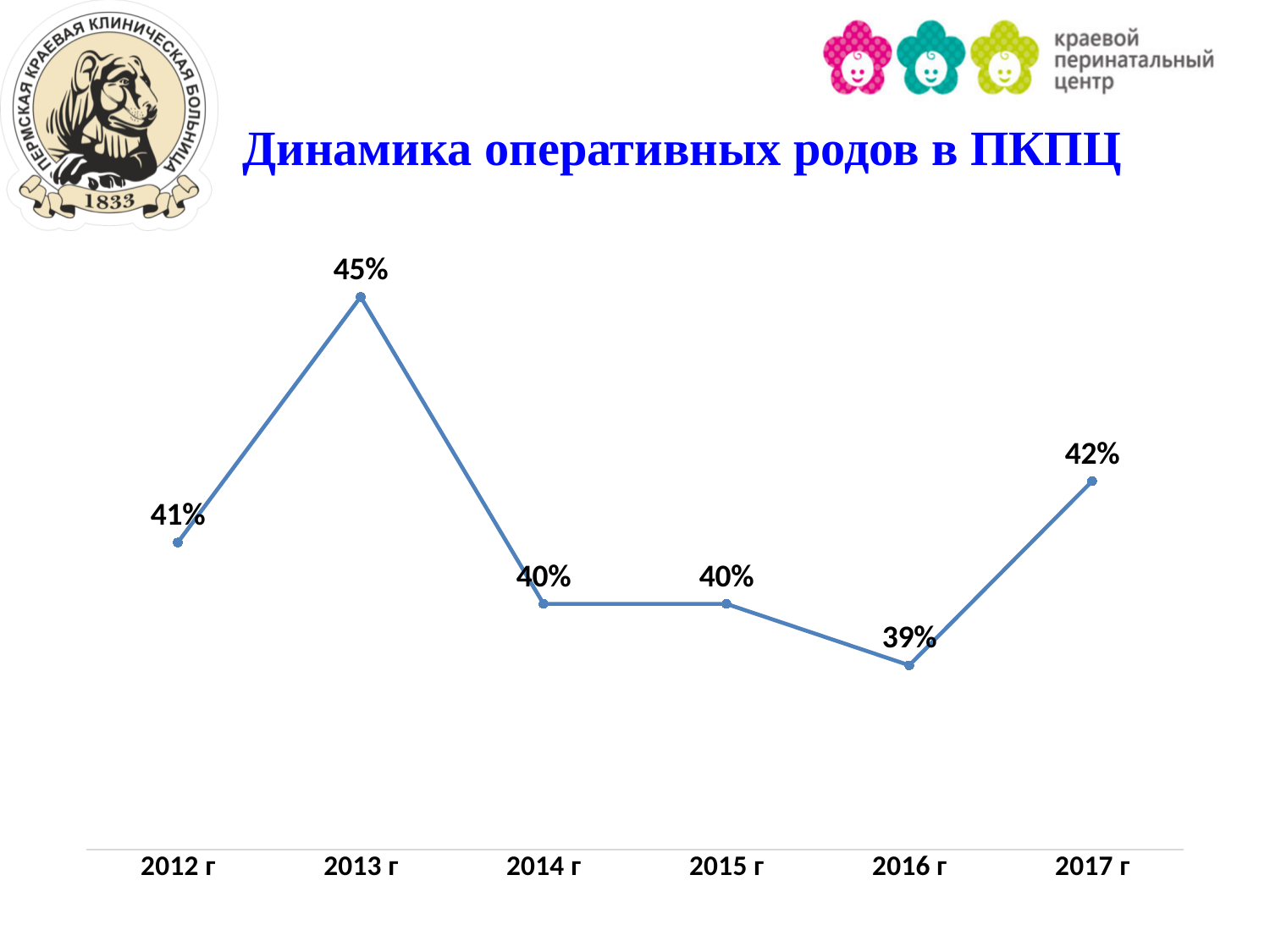
How many years are plotted on the chart? 6 What is the value for 2017 г? 42% Which year has the lowest value? 2016 г Does the value rise or fall from 2016 г to 2017 г? Rise What is the value for 2016 г? 39% What is the value for 2013 г? 45% What is the difference between the values for 2017 г and 2012 г? 1% What is the difference between the values for 2013 г and 2016 г? 6% Which year has the highest value? 2013 г What is the value for 2012 г? 41% What kind of chart is shown on the slide? Line chart Which is larger, the value for 2012 г or the value for 2017 г? 2017 г